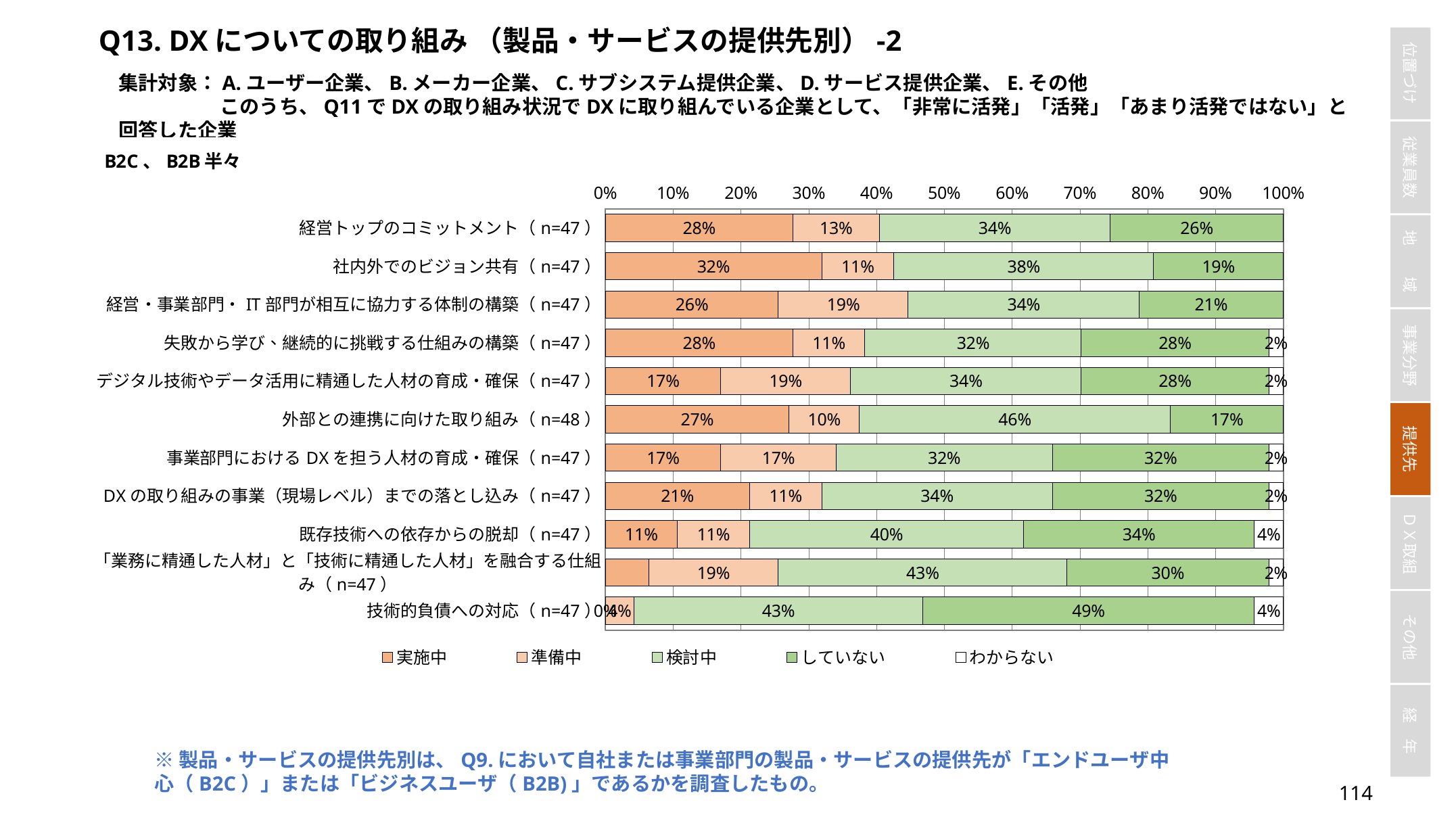
What is the 実施中 value for 社内外でのビジョン共有 (n=47)? 32% What is the していない value for 技術的負債への対応 (n=47)? 49% Which category has the highest していない value? 技術的負債への対応 (n=47) Which category has the lowest 実施中 value? 技術的負債への対応 (n=47) Which category has the highest 実施中 value? 社内外でのビジョン共有 (n=47) What kind of chart is shown on the slide? Stacked bar chart How many categories (rows) are plotted in the chart? 11 What is the 準備中 value for 経営・事業部門・IT部門が相互に協力する体制の構築 (n=47)? 19% What is the difference between the 検討中 value and the 実施中 value for 経営トップのコミットメント (n=47)? 6% Which is larger for 既存技術への依存からの脱却 (n=47): the 検討中 value or the していない value? 検討中 What is the 検討中 value for 外部との連携に向けた取り組み (n=48)? 46% How many series does the legend list? 5